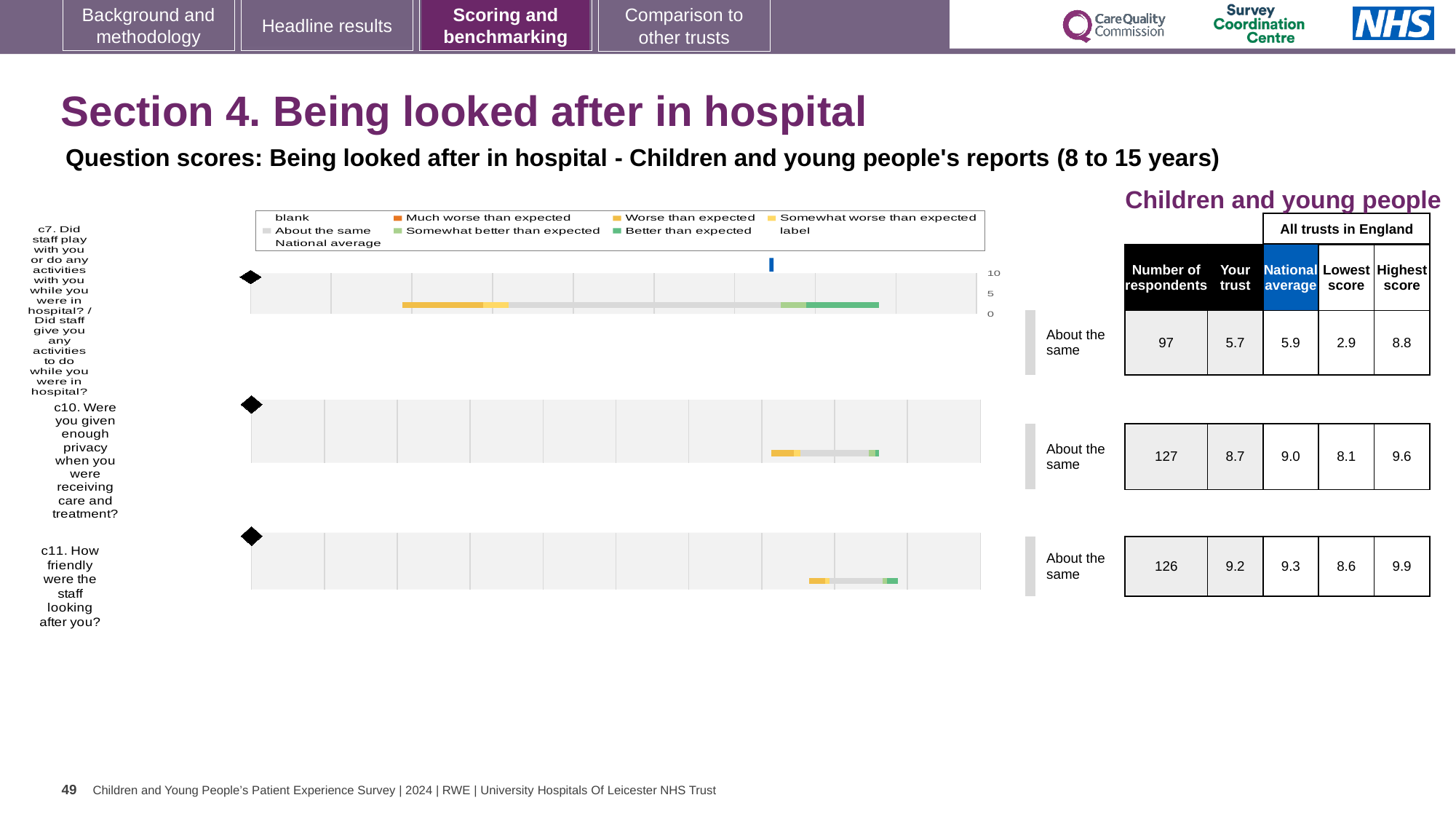
What is the difference between the highest and lowest scores across all trusts for question c11? 1.3 For question c11, which is larger: the 'Your trust' score or the national average? National average What is the highest score among all trusts in England for question c10? 9.6 How many questions (bars) are plotted on the slide? 3 What is the difference between the national average and the 'Your trust' score for question c7? 0.2 What is the lowest score among all trusts in England for question c7? 2.9 What benchmark category is shown for question c10? About the same What is the 'Your trust' score for question c10 (Were you given enough privacy when you were receiving care and treatment?)? 8.7 What kind of chart is used to show the question scores on this slide? Bar chart What is the national average score for question c11 (How friendly were the staff looking after you?)? 9.3 How many respondents answered question c7 (Did staff play with you or do any activities with you while you were in hospital?)? 97 Which question has the highest 'Your trust' score? c11. How friendly were the staff looking after you?